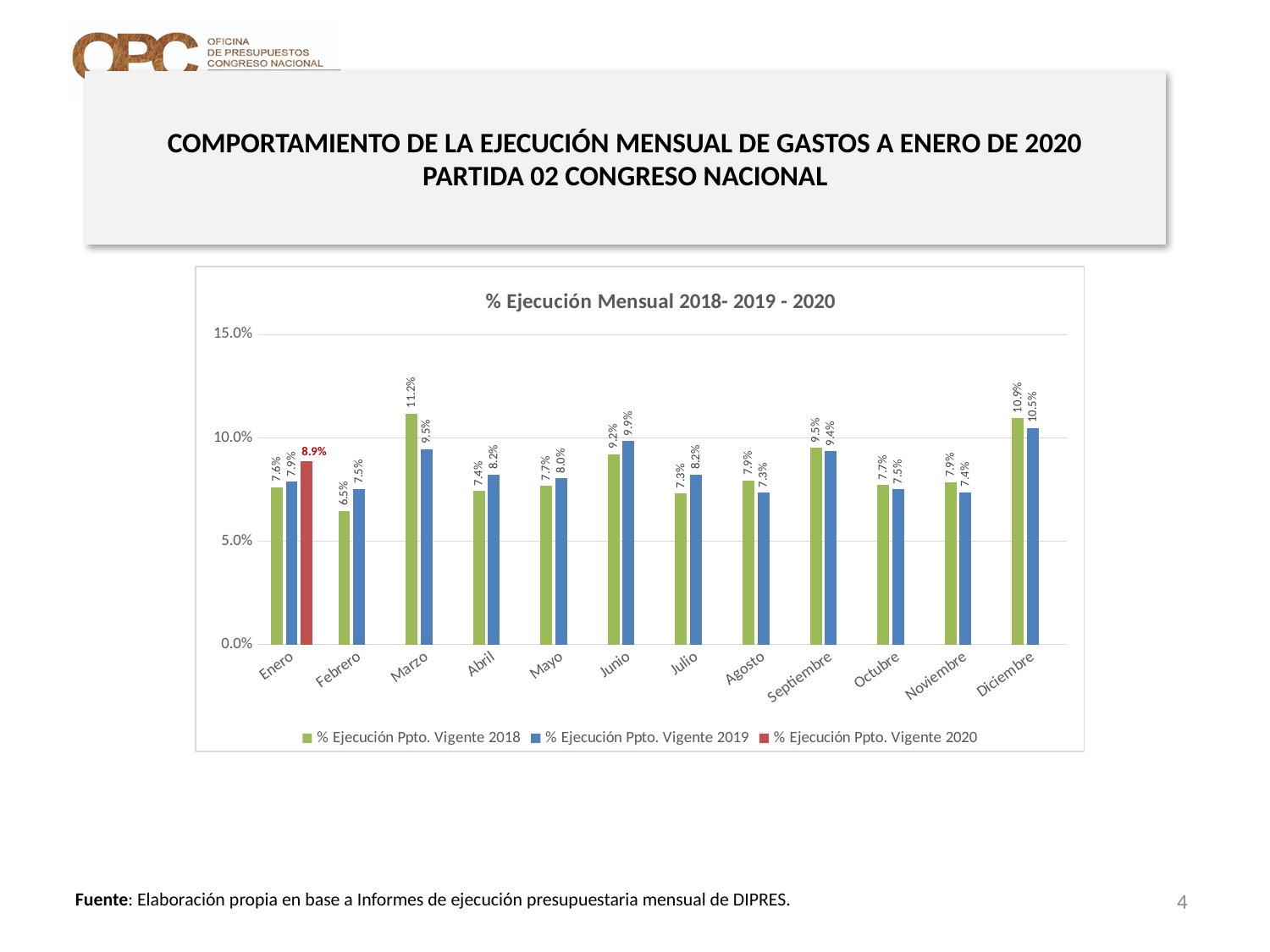
What is the value for % Ejecución Ppto. Vigente 2020 in Enero? 8.9% What is the difference between the 2018 and 2019 values in Marzo? 1.7 percentage points What is the value for % Ejecución Ppto. Vigente 2019 in Diciembre? 10.5% What is the value for % Ejecución Ppto. Vigente 2018 in Marzo? 11.2% How many months are shown on the x axis? 12 What kind of chart is shown on the slide? Bar chart What is the value for % Ejecución Ppto. Vigente 2019 in Junio? 9.9% Is the value for % Ejecución Ppto. Vigente 2018 in Diciembre greater or less than 10.0%? greater Which month has the highest value for % Ejecución Ppto. Vigente 2018? Marzo How many series does the legend list? 3 In Abril, which is larger: the 2018 value or the 2019 value? 2019 Which month has the lowest value for % Ejecución Ppto. Vigente 2018? Febrero